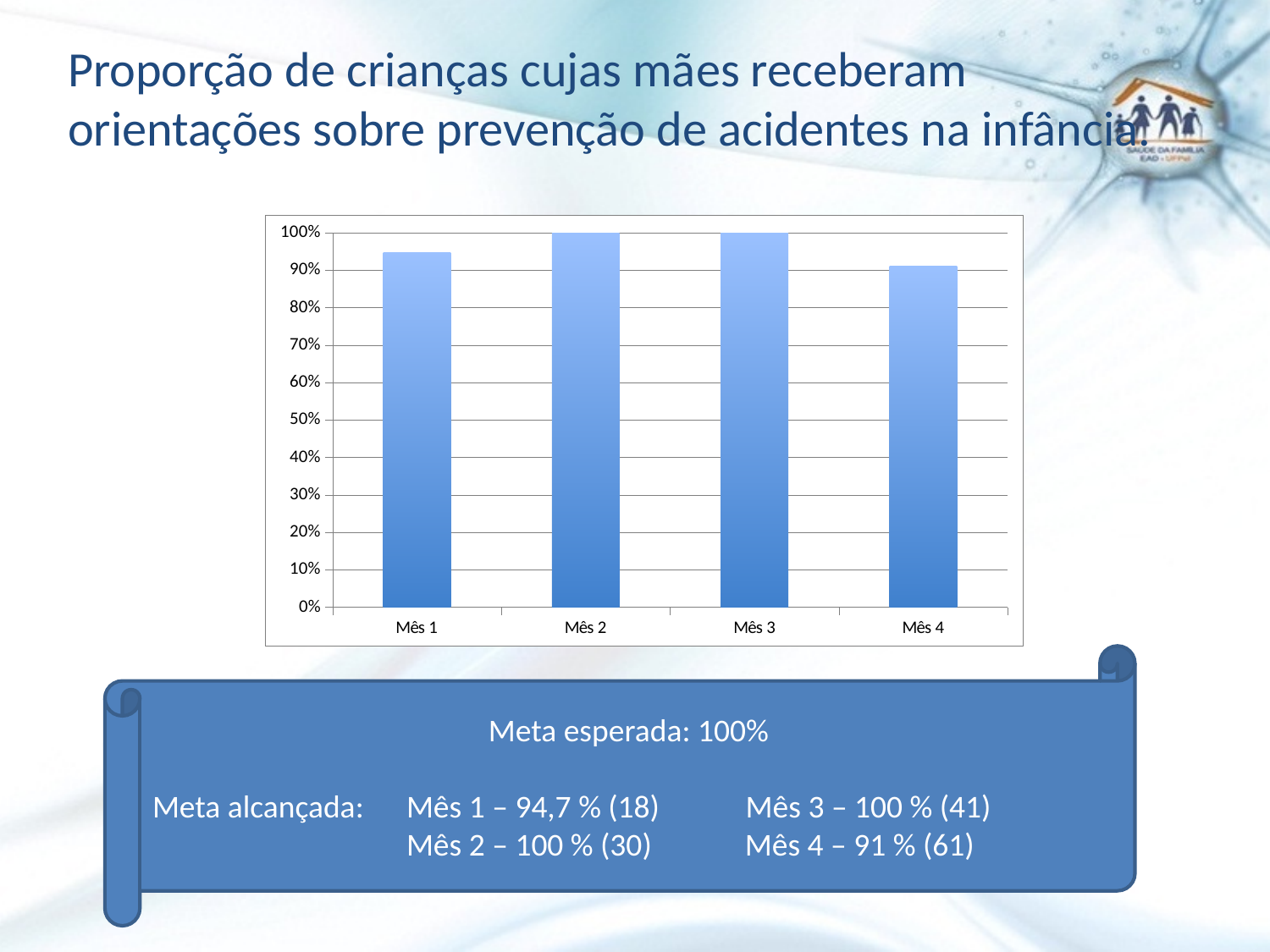
Which month has the lowest value in the chart? Mês 4 What kind of chart is shown on the slide? bar chart What is the value for Mês 1 in the chart? 94,7 % What is the difference between the values for Mês 1 and Mês 4? 3,7 % What is the value for Mês 2 in the chart? 100 % What is the expected target (meta esperada) stated on the slide? 100% What is the value for Mês 3 in the chart? 100 % What is the value for Mês 4 in the chart? 91 % How many categories (months) are plotted on the x axis of the chart? 4 Is the value for Mês 1 greater or less than 90%? greater Which is larger, the value for Mês 1 or the value for Mês 4? Mês 1 Is the value for Mês 4 greater or less than 100%? less